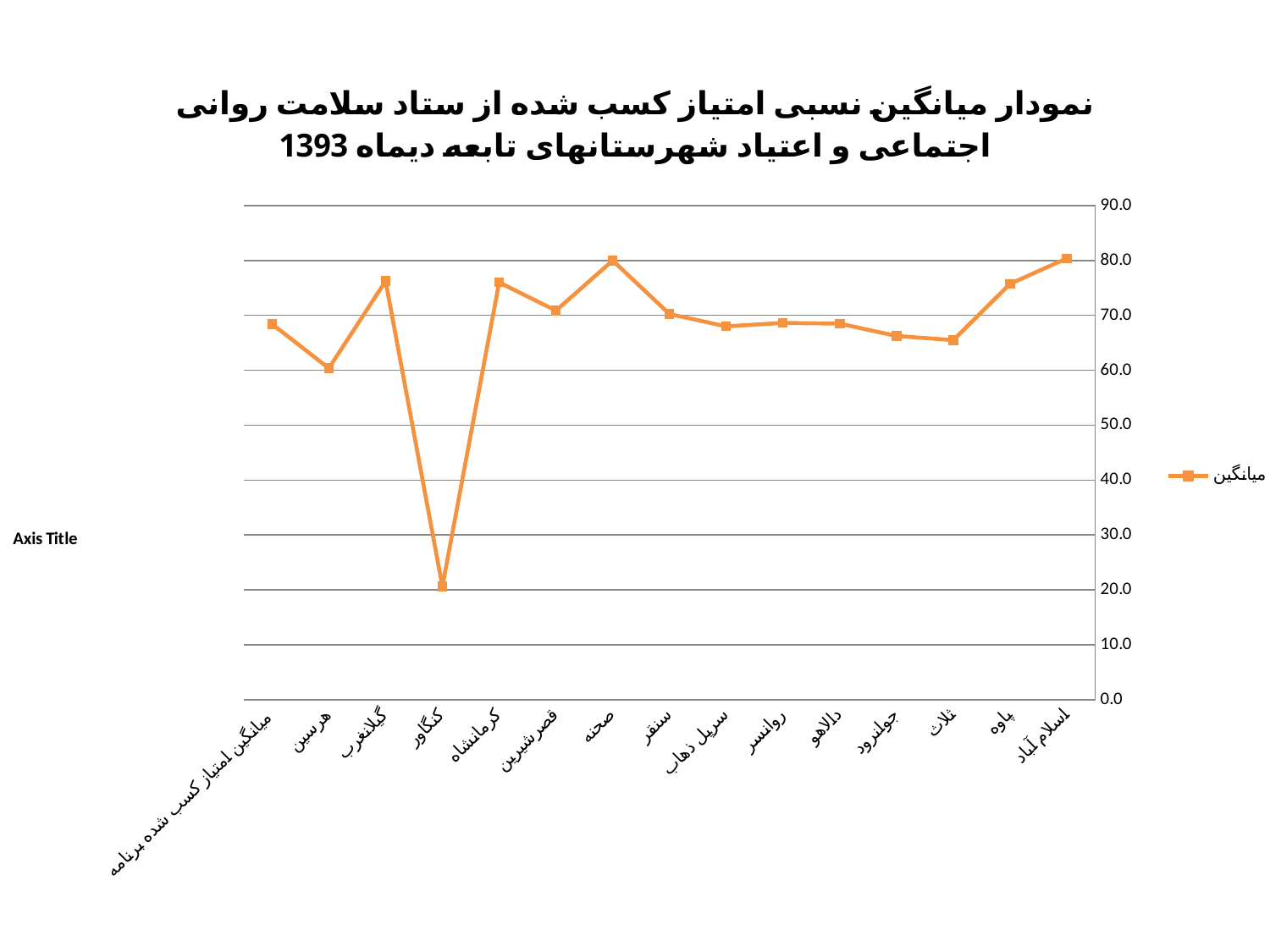
What is the legend entry for the plotted series? میانگین What kind of chart is shown on the slide? line chart How many categories are plotted along the x axis? 15 Which has the larger value, کنگاور or کرمانشاه? کرمانشاه Is the value for گیلانغرب greater or less than 70? greater Is the value for کنگاور greater or less than 30? less Which category has the lowest value? کنگاور How many series does the legend list? 1 Does the line rise or fall from کنگاور to کرمانشاه? rise Is the value for هرسین greater or less than 50? greater Which has the larger value, هرسین or گیلانغرب? گیلانغرب